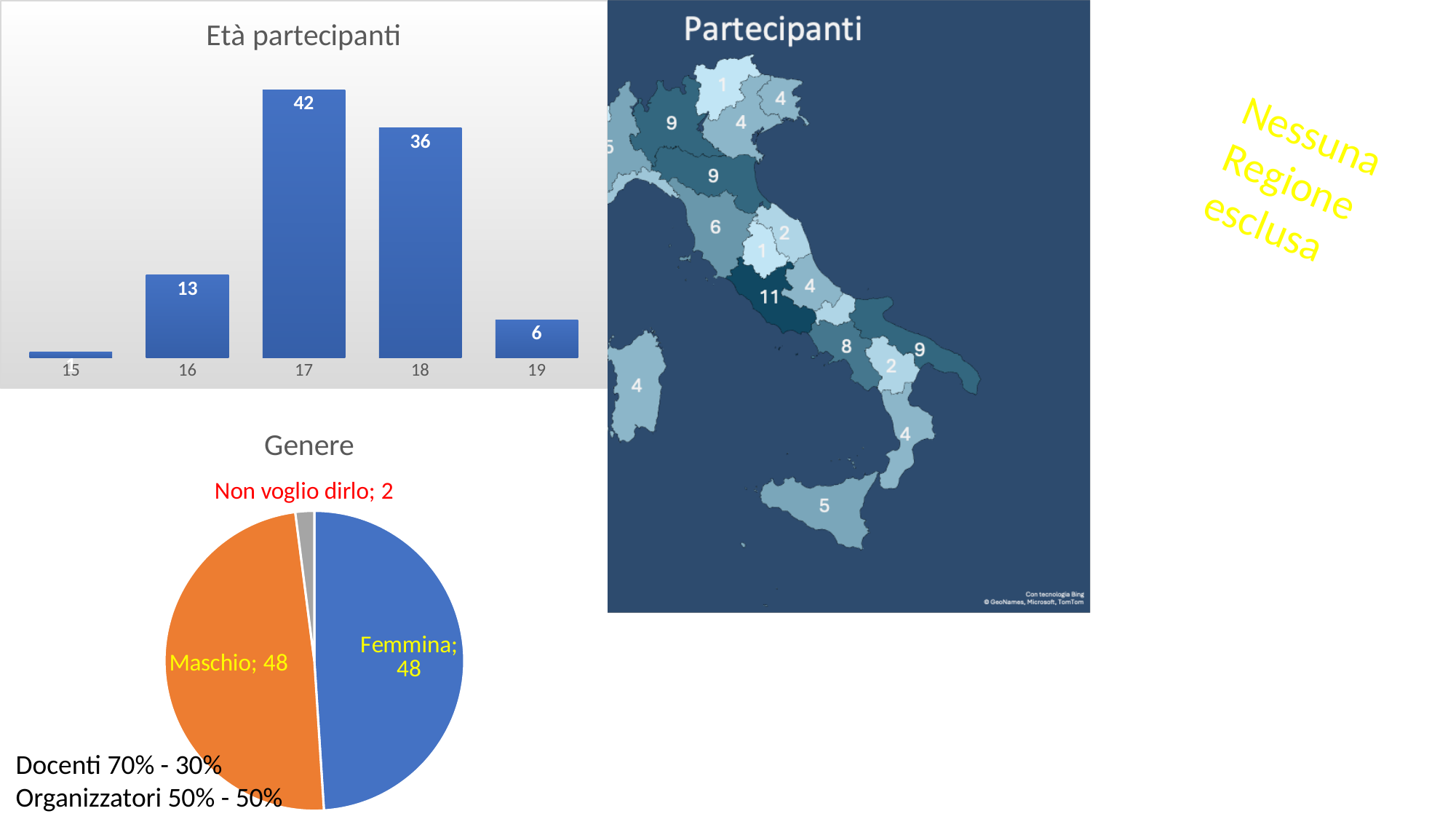
In the 'Età partecipanti' chart, which age has the highest value? 17 In the 'Genere' pie chart, what is the value for 'Non voglio dirlo'? 2 In the 'Età partecipanti' chart, what is the difference between the values for age 17 and age 18? 6 In the 'Età partecipanti' chart, what is the value for age 19? 6 In the 'Genere' pie chart, which category has the smallest slice? Non voglio dirlo What kind of chart is 'Età partecipanti'? bar chart How many age categories are shown in the 'Età partecipanti' chart? 5 In the 'Età partecipanti' chart, what is the value for age 17? 42 In the 'Genere' pie chart, what is the value for Maschio? 48 In the 'Età partecipanti' chart, which is larger, the value for age 16 or age 18? 18 In the 'Età partecipanti' chart, which age has the lowest value? 15 In the 'Partecipanti' map chart, what is the highest value shown for a region? 11